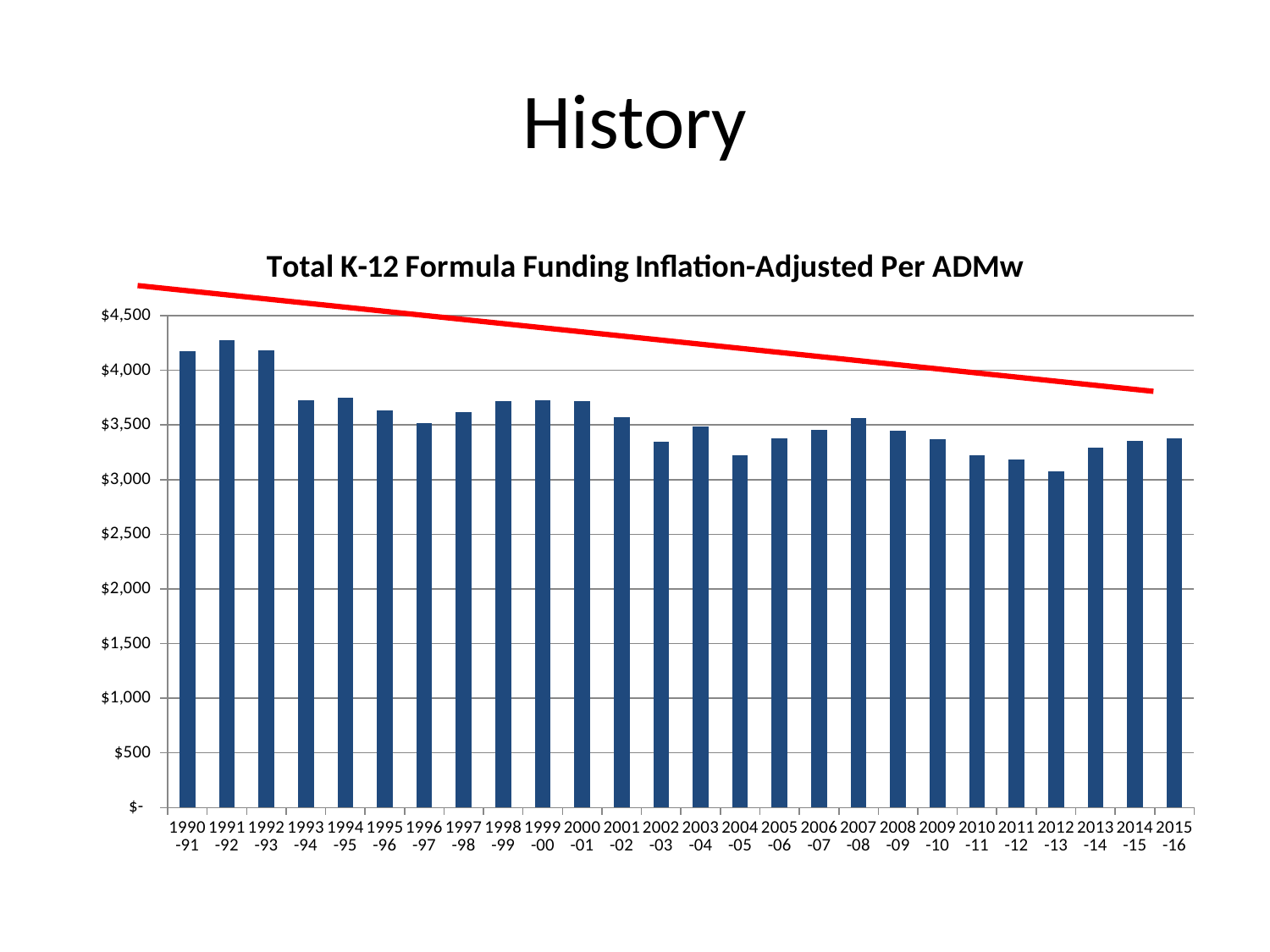
Is the value for 2012-13 greater or less than $3,000? greater How many school years are plotted on the x axis? 26 Which is larger, the value for 2007-08 or the value for 2010-11? 2007-08 Is the value for 2004-05 greater or less than $3,500? less Is the value for 1990-91 greater or less than $4,000? greater Which school year has the highest funding per ADMw? 1991-92 What is the title of the chart? Total K-12 Formula Funding Inflation-Adjusted Per ADMw Overall, do the values rise or fall from 1990-91 to 2015-16? Fall What type of chart is shown on the slide? Bar chart Which school year has the lowest funding per ADMw? 2012-13 Which is larger, the value for 1993-94 or the value for 2004-05? 1993-94